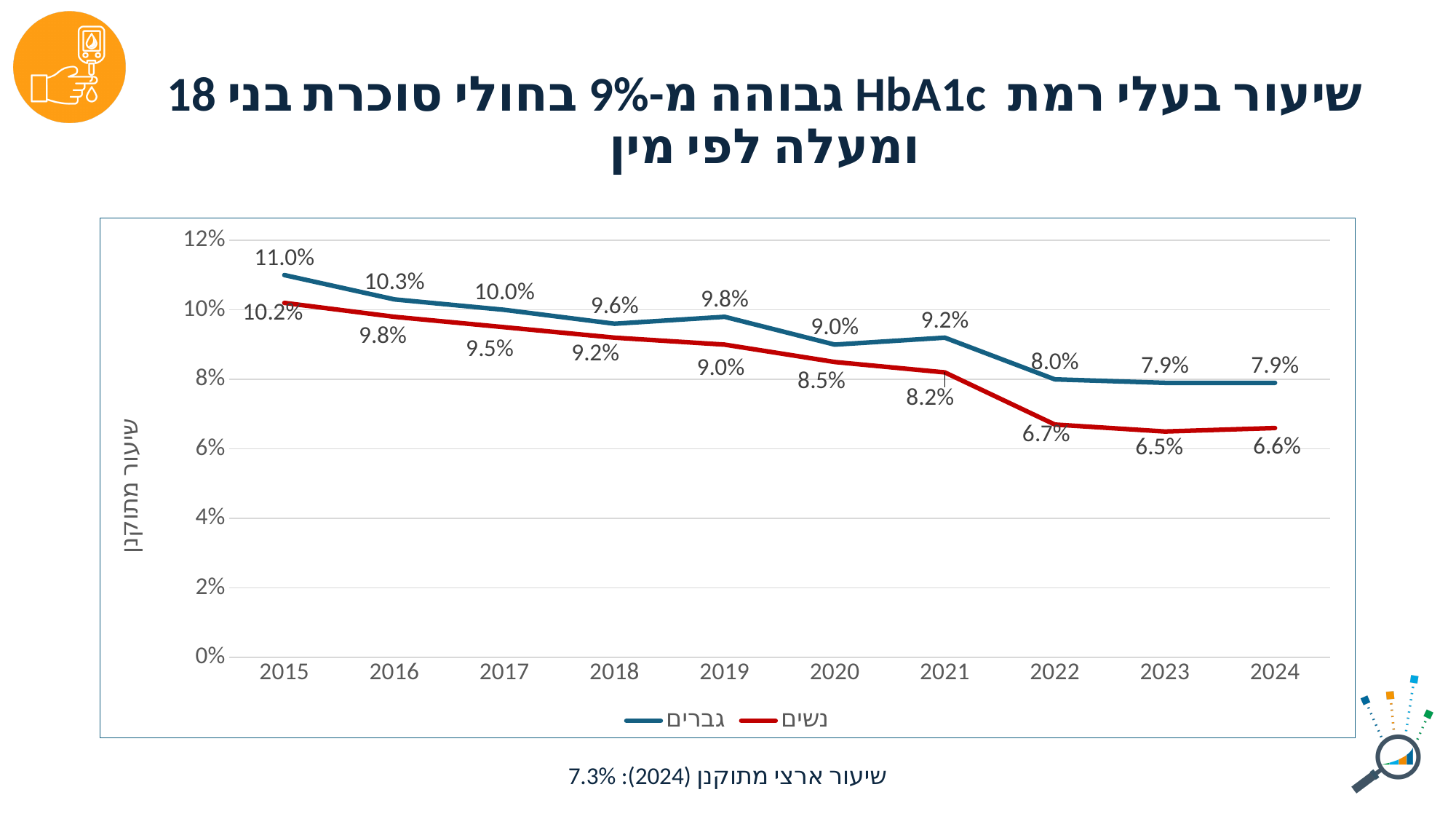
Do the values for נשים (women) generally rise or fall from 2015 to 2024? fall What type of chart is shown on the slide? line chart What is the value for נשים (women) in 2021? 8.2% How many years are shown on the x axis? 10 Which series has the larger value in 2019, גברים (men) or נשים (women)? גברים (men) In which year is the value for גברים (men) highest? 2015 How many series does the legend list? 2 What is the value for גברים (men) in 2015? 11.0% What is the difference between the גברים (men) and נשים (women) values in 2022? 1.3% What is the value for נשים (women) in 2024? 6.6% In which year is the value for נשים (women) lowest? 2023 Which colour is used for the נשים (women) series? red